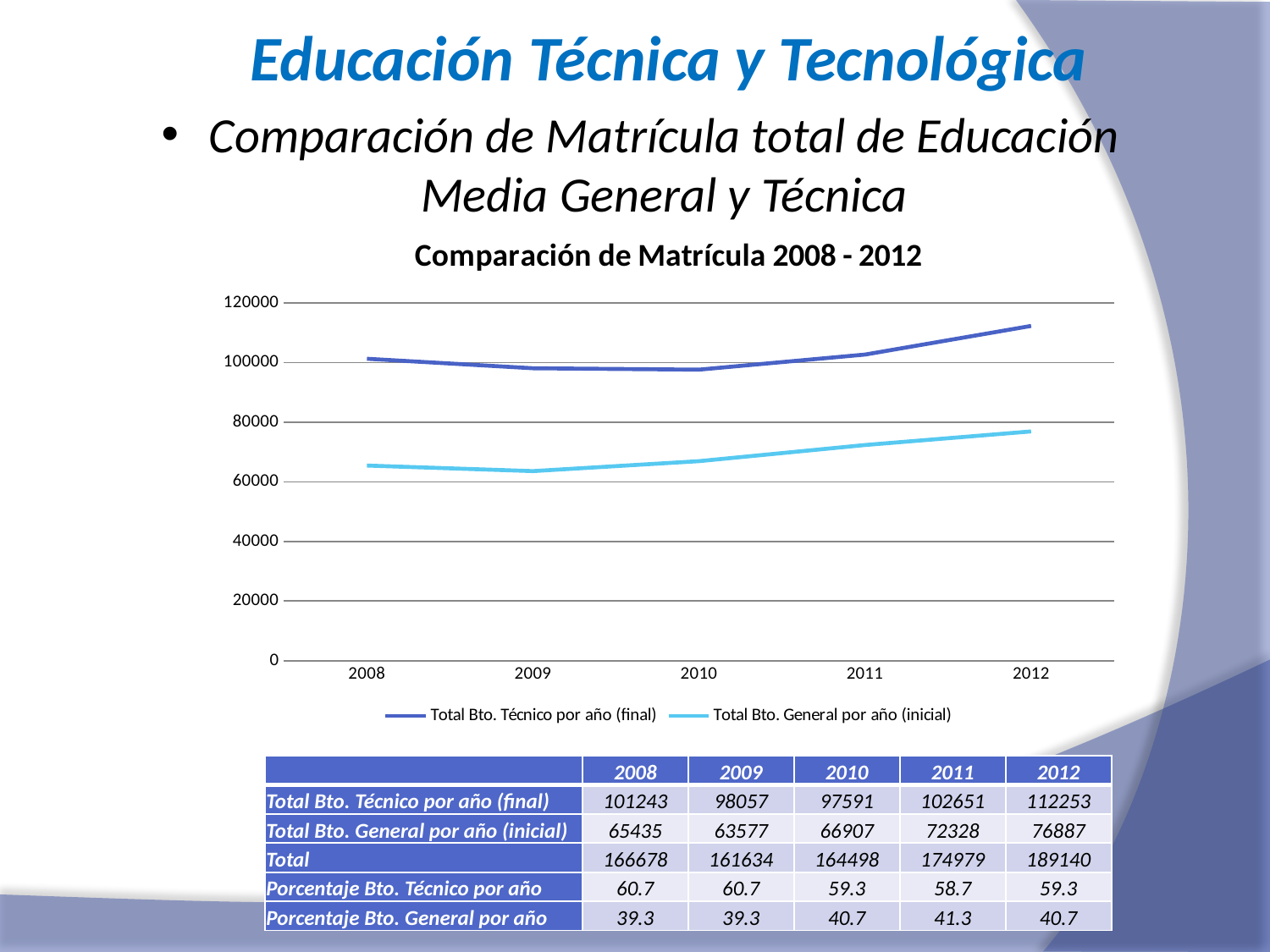
Which series has the higher value in 2011, Total Bto. Técnico por año (final) or Total Bto. General por año (inicial)? Total Bto. Técnico por año (final) In which year is Total Bto. General por año (inicial) highest? 2012 How many series does the chart legend list? 2 How many years are plotted along the x axis of the chart? 5 Is the value for Total Bto. General por año (inicial) in 2012 greater or less than 80000? less In which year is Total Bto. Técnico por año (final) lowest? 2010 What is the value of Total Bto. Técnico por año (final) in 2012? 112253 What is the title of the chart? Comparación de Matrícula 2008 - 2012 What kind of chart is shown on the slide? line chart Does Total Bto. General por año (inicial) rise or fall from 2009 to 2012? rise What is the value of Total Bto. General por año (inicial) in 2009? 63577 What is the difference between Total Bto. Técnico por año (final) and Total Bto. General por año (inicial) in 2008? 35808